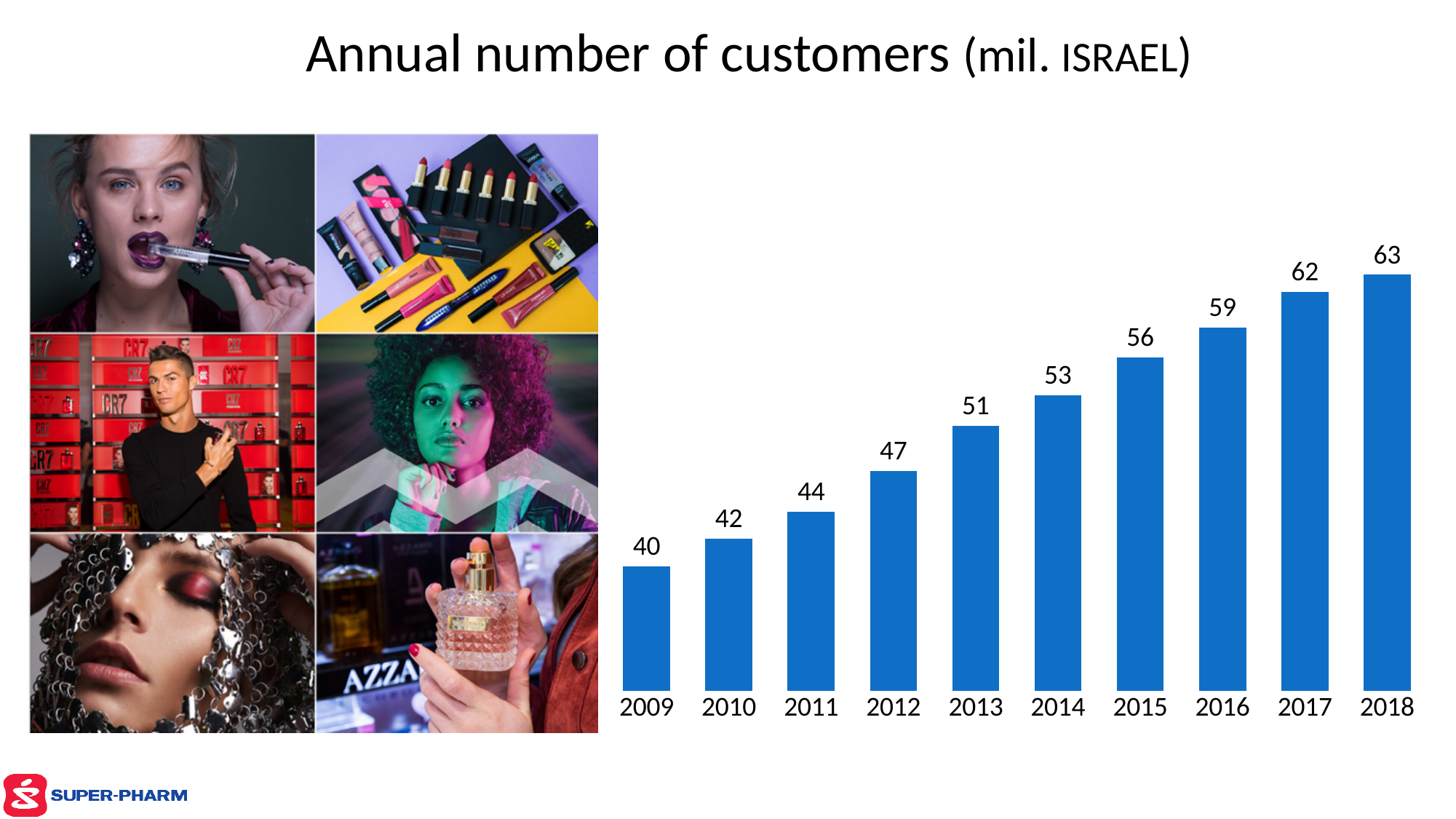
What is the difference between the values for 2018 and 2009? 23 What is the value for 2016? 59 What is the annual number of customers shown for 2013? 51 What kind of chart is shown on the slide? bar chart By how much did the value increase from 2014 to 2015? 3 Do the values rise or fall from 2009 to 2018? rise What value is shown for 2009? 40 Which year has the highest number of customers? 2018 Which year has the lowest number of customers? 2009 What is the title of the chart? Annual number of customers (mil. ISRAEL) Which is larger, the value for 2012 or the value for 2011? 2012 How many years are shown on the x axis? 10